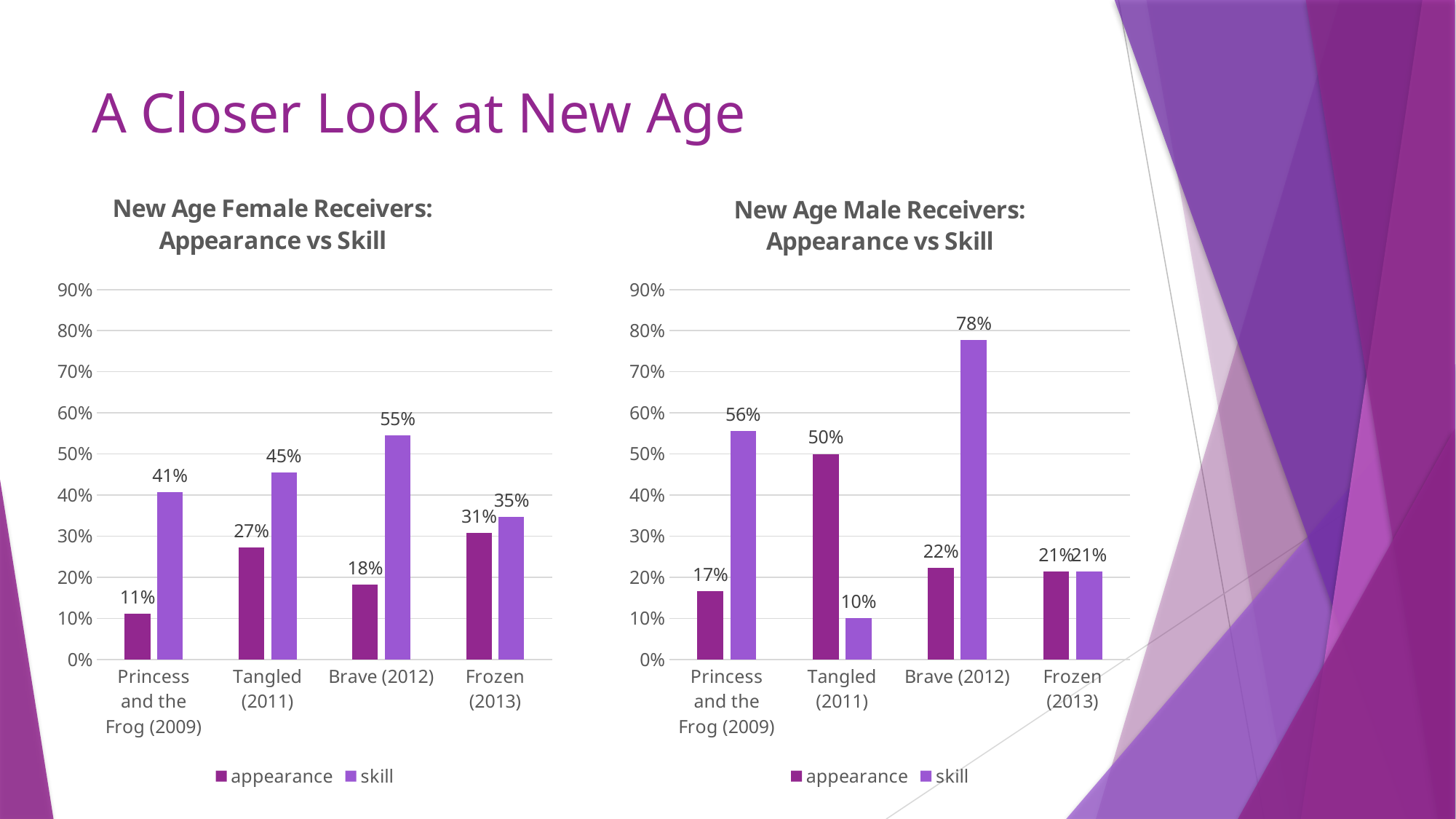
In the 'New Age Male Receivers: Appearance vs Skill' chart, which is larger for Tangled (2011): appearance or skill? appearance What kind of chart is the 'New Age Female Receivers: Appearance vs Skill' chart? bar chart In the 'New Age Male Receivers: Appearance vs Skill' chart, how many series does the legend list? 2 In the 'New Age Male Receivers: Appearance vs Skill' chart, which film has the highest skill value? Brave (2012) In the 'New Age Male Receivers: Appearance vs Skill' chart, what are the two legend entries? appearance, skill In the 'New Age Female Receivers: Appearance vs Skill' chart, which film has the lowest appearance value? Princess and the Frog (2009) In the 'New Age Female Receivers: Appearance vs Skill' chart, does the skill value rise or fall from Princess and the Frog (2009) to Brave (2012)? rise In the 'New Age Female Receivers: Appearance vs Skill' chart, how many films are shown on the x axis? 4 In the 'New Age Female Receivers: Appearance vs Skill' chart, what is the skill value for Brave (2012)? 55% In the 'New Age Male Receivers: Appearance vs Skill' chart, what is the difference between the skill and appearance values for Brave (2012)? 56% In the 'New Age Male Receivers: Appearance vs Skill' chart, what is the appearance value for Tangled (2011)? 50% In the 'New Age Female Receivers: Appearance vs Skill' chart, what is the difference between the skill and appearance values for Tangled (2011)? 18%